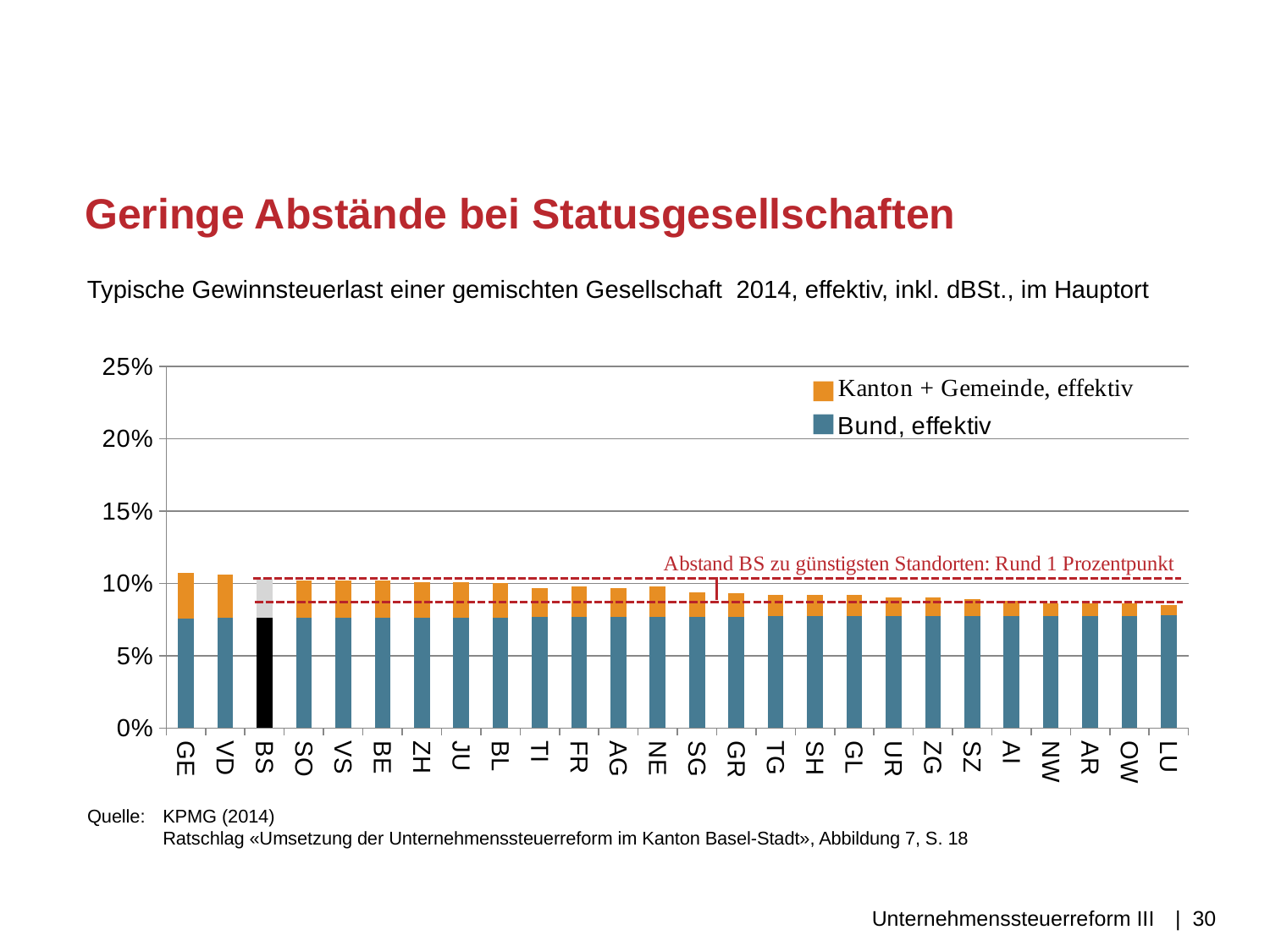
Is the total value for GE greater or less than 10%? greater Which has the larger total value, GE or LU? GE Do the total values generally rise or fall from left to right along the x axis? fall What kind of chart is shown on the slide? Stacked bar chart How many cantons (categories) are shown on the x axis of the chart? 26 How many series does the chart legend list? 2 Which two series are listed in the chart legend? Kanton + Gemeinde, effektiv; Bund, effektiv What does the red annotation on the chart say about the gap between BS and the cheapest locations? Abstand BS zu günstigsten Standorten: Rund 1 Prozentpunkt Is the 'Bund, effektiv' value for SO greater or less than 10%? less Is the total value for LU greater or less than 10%? less